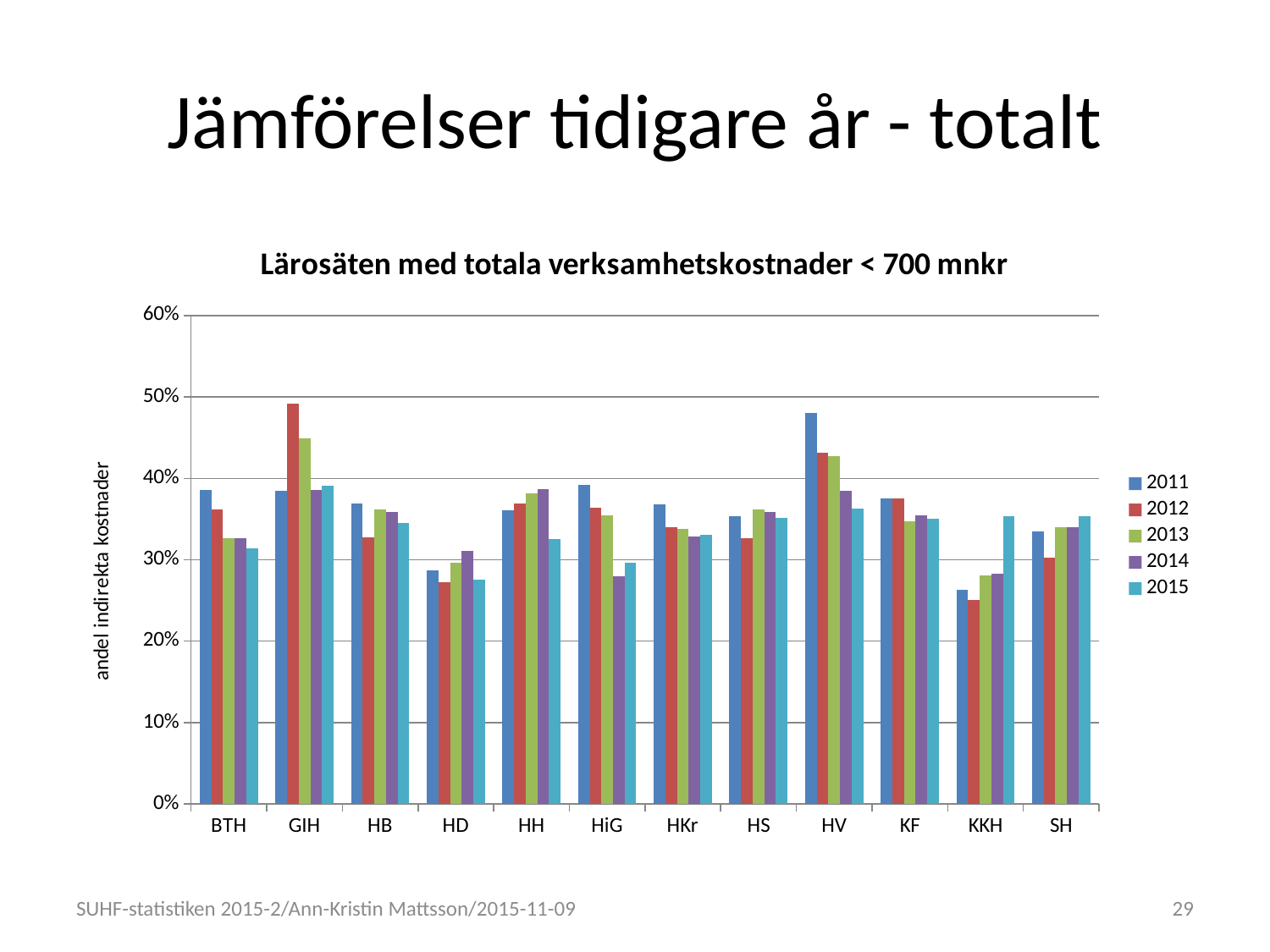
How many institutions (categories) are shown on the x axis of the chart? 12 Is the 2012 value for GIH greater or less than 40%? greater Which institution has the highest value for 2012? GIH Which is larger for HV: the 2011 value or the 2015 value? 2011 What kind of chart is shown on the slide? bar chart Which institution has the highest value for 2011? HV What is the label of the vertical axis? andel indirekta kostnader Is the 2012 value for KKH greater or less than 30%? less What is the title of the chart? Lärosäten med totala verksamhetskostnader < 700 mnkr Do the values for HV rise or fall from 2011 to 2015? fall Which institution has the lowest value for 2012? KKH How many series does the legend list? 5